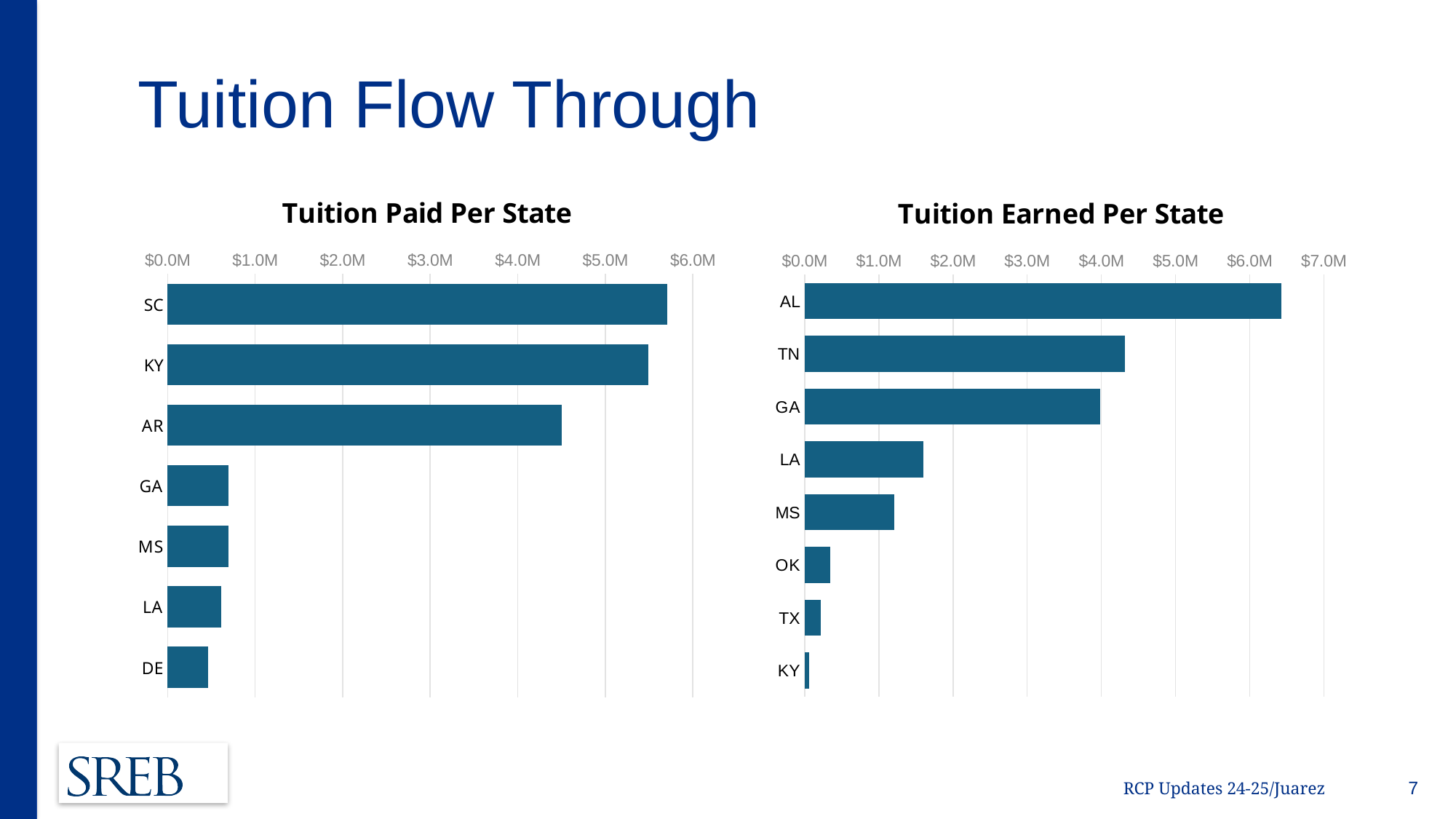
How many states are shown in the "Tuition Paid Per State" chart? 7 What is the title of the chart on the right side of the slide? Tuition Earned Per State In the "Tuition Earned Per State" chart, is the value for LA greater or less than $2.0M? less In the "Tuition Earned Per State" chart, which state has the lowest value? KY In the "Tuition Earned Per State" chart, which state has the highest value? AL In the "Tuition Paid Per State" chart, is the value for AR greater or less than $4.0M? greater What kind of chart is the "Tuition Paid Per State" chart? bar chart In the "Tuition Earned Per State" chart, is the value for AL greater or less than $6.0M? greater How many states are shown in the "Tuition Earned Per State" chart? 8 In the "Tuition Paid Per State" chart, which state has the lowest value? DE In the "Tuition Paid Per State" chart, which state has the highest value? SC In the "Tuition Earned Per State" chart, which is larger, the value for TN or the value for LA? TN